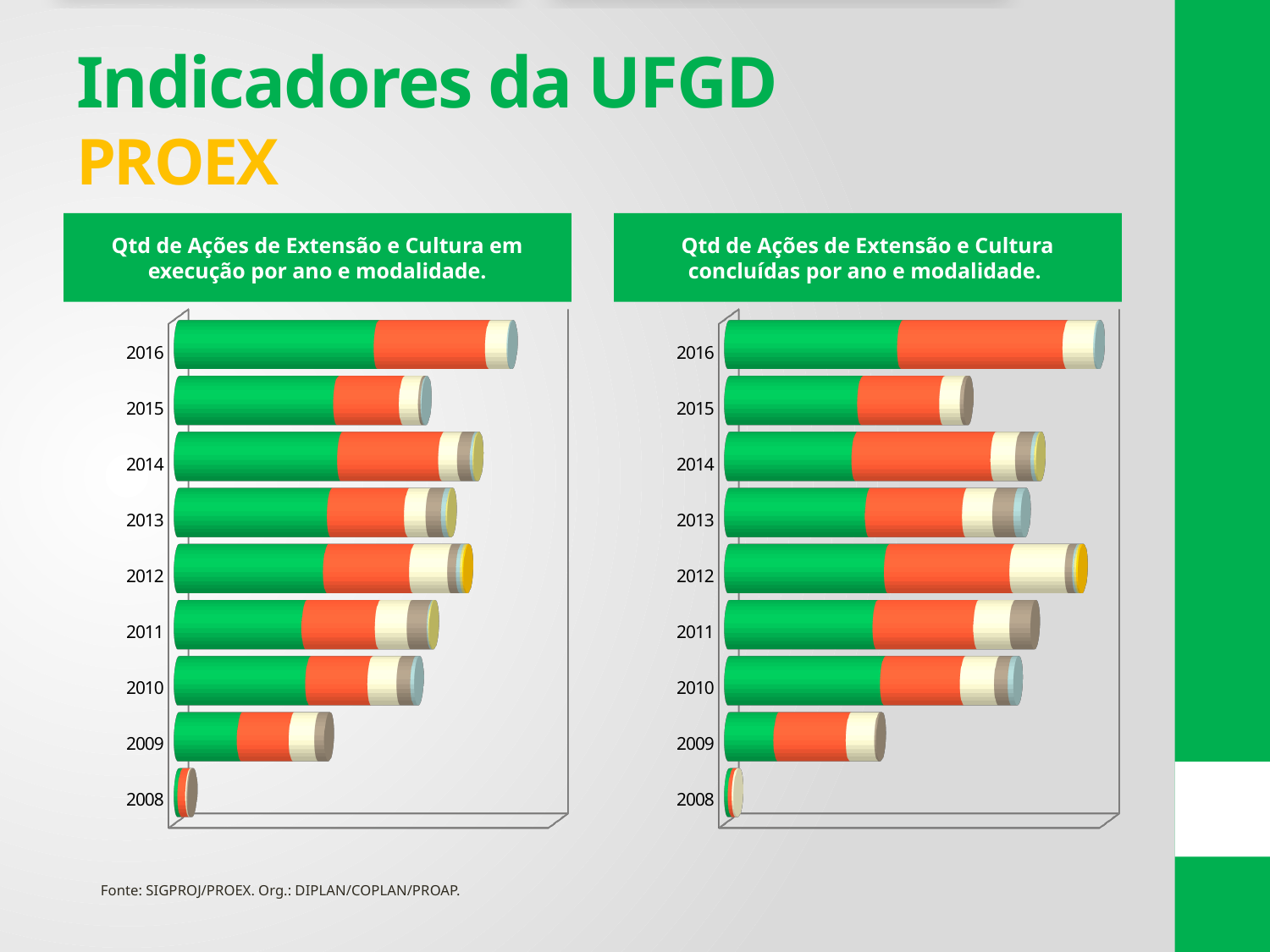
In the right chart (ações concluídas), which bar is longer, 2009 or 2011? 2011 In the left chart (ações em execução), what colour is the first segment of each bar? Green In the left chart (ações em execução), which year has the shortest bar? 2008 In the right chart (ações concluídas), which year has the shortest bar? 2008 In the right chart (ações concluídas), which bar is longer, 2014 or 2015? 2014 What kind of chart is shown under the title 'Qtd de Ações de Extensão e Cultura em execução por ano e modalidade.'? Stacked bar chart In the right chart (ações concluídas), how many years are plotted? 9 In the left chart (ações em execução), which bar is longer, 2014 or 2015? 2014 In the left chart (ações em execução), how many years are plotted? 9 What is the title of the chart on the right side of the slide? Qtd de Ações de Extensão e Cultura concluídas por ano e modalidade. In the left chart (ações em execução), which year has the longest bar? 2016